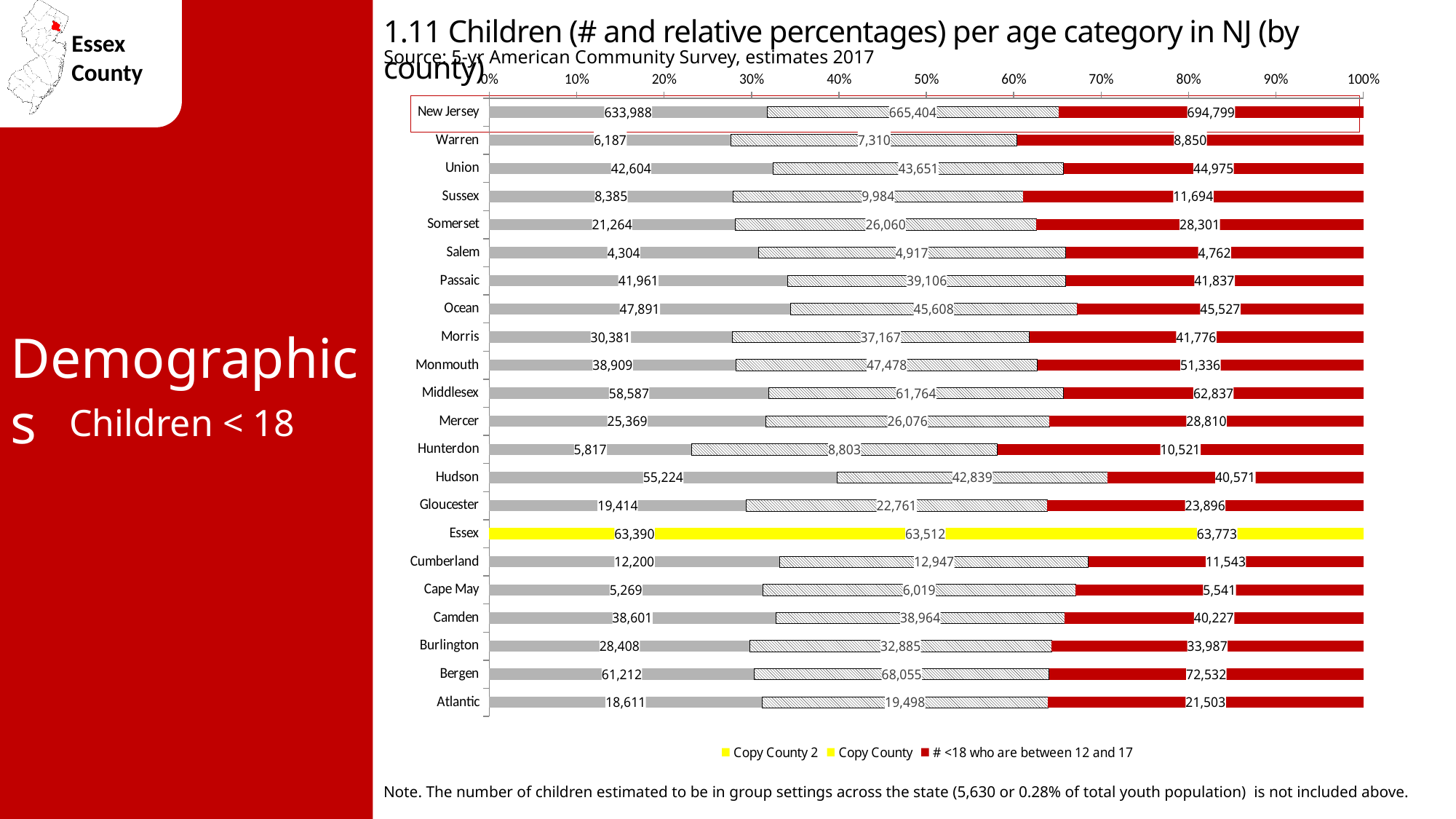
What is the difference between the rightmost segment value and the leftmost segment value on the Bergen bar? 11,320 What is the value printed on the leftmost segment of the Hudson bar? 55,224 Which has the larger leftmost segment value, Hudson or Bergen? Bergen How many bars (rows) are plotted in the chart? 22 What is the value printed on the rightmost (red) segment of the Essex bar? 63,773 Which bar is highlighted in yellow? Essex What is the value printed on the leftmost segment of the New Jersey bar? 633,988 Among the counties (excluding the New Jersey bar), which has the largest value printed on its leftmost segment? Essex What is the total of the three values printed on the Essex bar? 190,675 What is the total of the three values printed on the Atlantic bar? 59,612 Is the leftmost segment of the Hunterdon bar greater or less than 30% of the bar? less What is the value printed on the middle (hatched) segment of the Hunterdon bar? 8,803